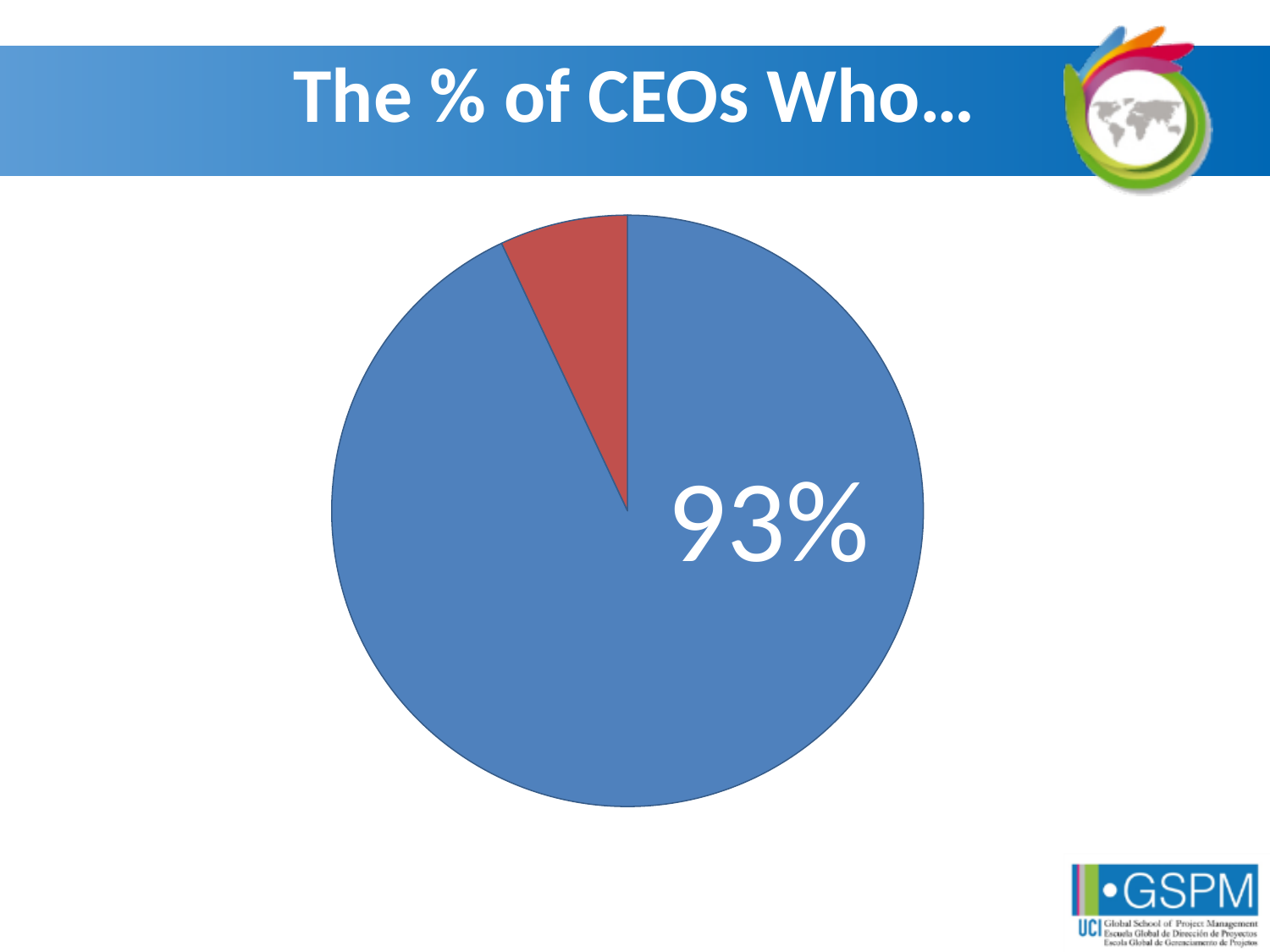
Which slice of the pie chart is the smallest? the red slice How many slices does the pie chart have? 2 What share of the pie does the blue slice represent? 93% Which slice of the pie chart is the largest? the blue slice What percentage is printed on the blue slice of the pie chart? 93% Which slice of the pie chart is larger, the blue one or the red one? the blue one What kind of chart is shown on the slide? pie chart What colour is the slice of the pie chart labelled 93%? blue Is the red slice of the pie chart greater or less than 50% of the pie? less What is the title of the slide containing the pie chart? The % of CEOs Who…